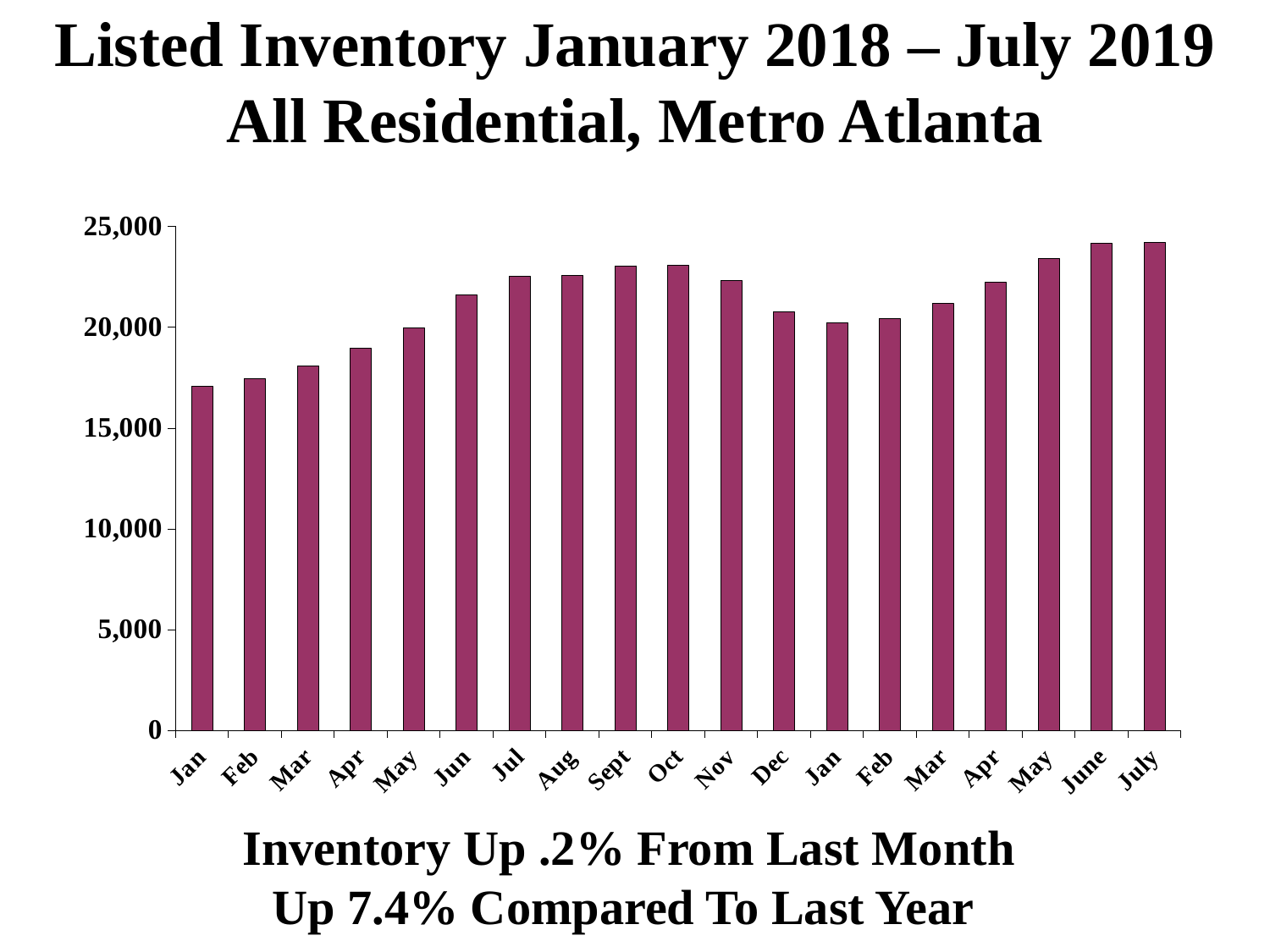
How many bars (months) are plotted in the chart? 19 Is the value for July 2019 (the last bar) greater or less than 20,000? greater Is the value for Jun 2018 greater or less than 20,000? greater Is the value for Mar 2018 greater or less than 15,000? greater Which is larger, the value for Jan 2018 or the value for Jan 2019? Jan 2019 What is the title of the chart? Listed Inventory January 2018 – July 2019 All Residential, Metro Atlanta What kind of chart is shown on the slide? bar chart Do the values rise or fall from Jan 2018 through Oct 2018? rise According to the text below the chart, by what percentage is inventory up compared to last year? 7.4% Which is larger, the value for Oct 2018 or the value for Dec 2018? Oct 2018